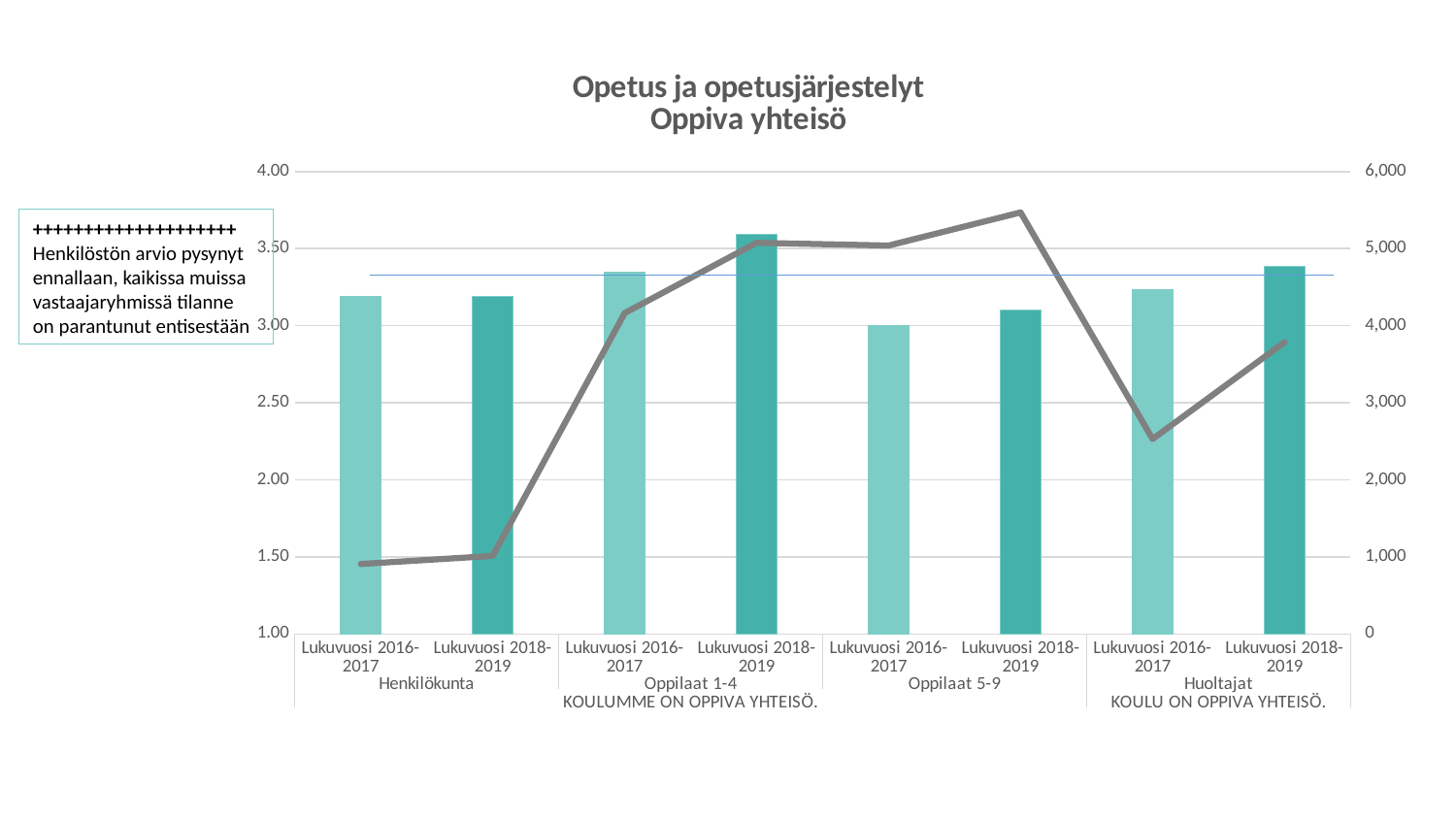
How many respondent groups are shown on the x axis (Henkilökunta, Oppilaat 1-4, Oppilaat 5-9, Huoltajat)? 4 What is the title of the chart? Opetus ja opetusjärjestelyt Oppiva yhteisö Is the bar value for Henkilökunta, Lukuvuosi 2016-2017 greater or less than 3.00 on the left axis? greater Is the bar value for Oppilaat 1-4, Lukuvuosi 2018-2019 greater or less than 3.50 on the left axis? greater For Oppilaat 1-4, which bar is taller: Lukuvuosi 2016-2017 or Lukuvuosi 2018-2019? Lukuvuosi 2018-2019 For Huoltajat, which bar is taller: Lukuvuosi 2016-2017 or Lukuvuosi 2018-2019? Lukuvuosi 2018-2019 Which bar is the highest in the chart? Oppilaat 1-4, Lukuvuosi 2018-2019 At which point does the grey line reach its highest value? Oppilaat 5-9, Lukuvuosi 2018-2019 How many bars are plotted in the chart? 8 Which bar is the lowest in the chart? Oppilaat 5-9, Lukuvuosi 2016-2017 Is the grey line value for Huoltajat, Lukuvuosi 2016-2017 greater or less than 3,000 on the right axis? less What kind of chart is shown on the slide? A combined bar and line chart